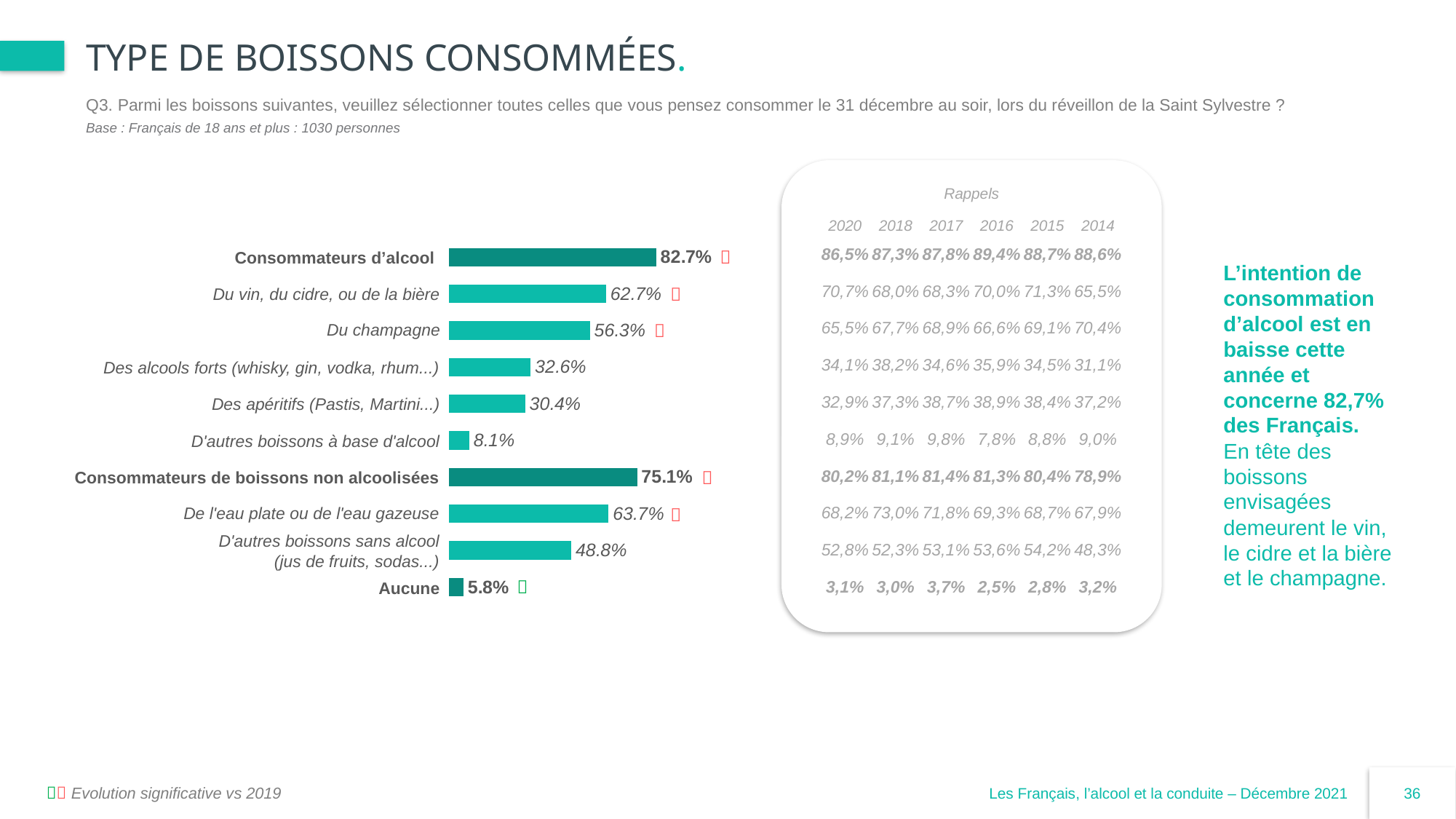
What is the difference between "Du vin, du cidre, ou de la bière" and "Du champagne"? 6.4 percentage points Which category has the lowest value in the chart? Aucune What is the value for "Aucune"? 5.8% What is the value for "Consommateurs d'alcool"? 82.7% How many categories (bars) are shown in the chart? 10 Which is larger: "Des alcools forts (whisky, gin, vodka, rhum...)" or "D'autres boissons sans alcool (jus de fruits, sodas...)"? D'autres boissons sans alcool (jus de fruits, sodas...) What is the value for "Des apéritifs (Pastis, Martini...)"? 30.4% What is the value for "D'autres boissons sans alcool (jus de fruits, sodas...)"? 48.8% What is the value for "Du champagne"? 56.3% What type of chart is shown on the slide? Bar chart What is the difference between "Consommateurs d'alcool" and "Consommateurs de boissons non alcoolisées"? 7.6 percentage points Which category has the highest value in the chart? Consommateurs d'alcool